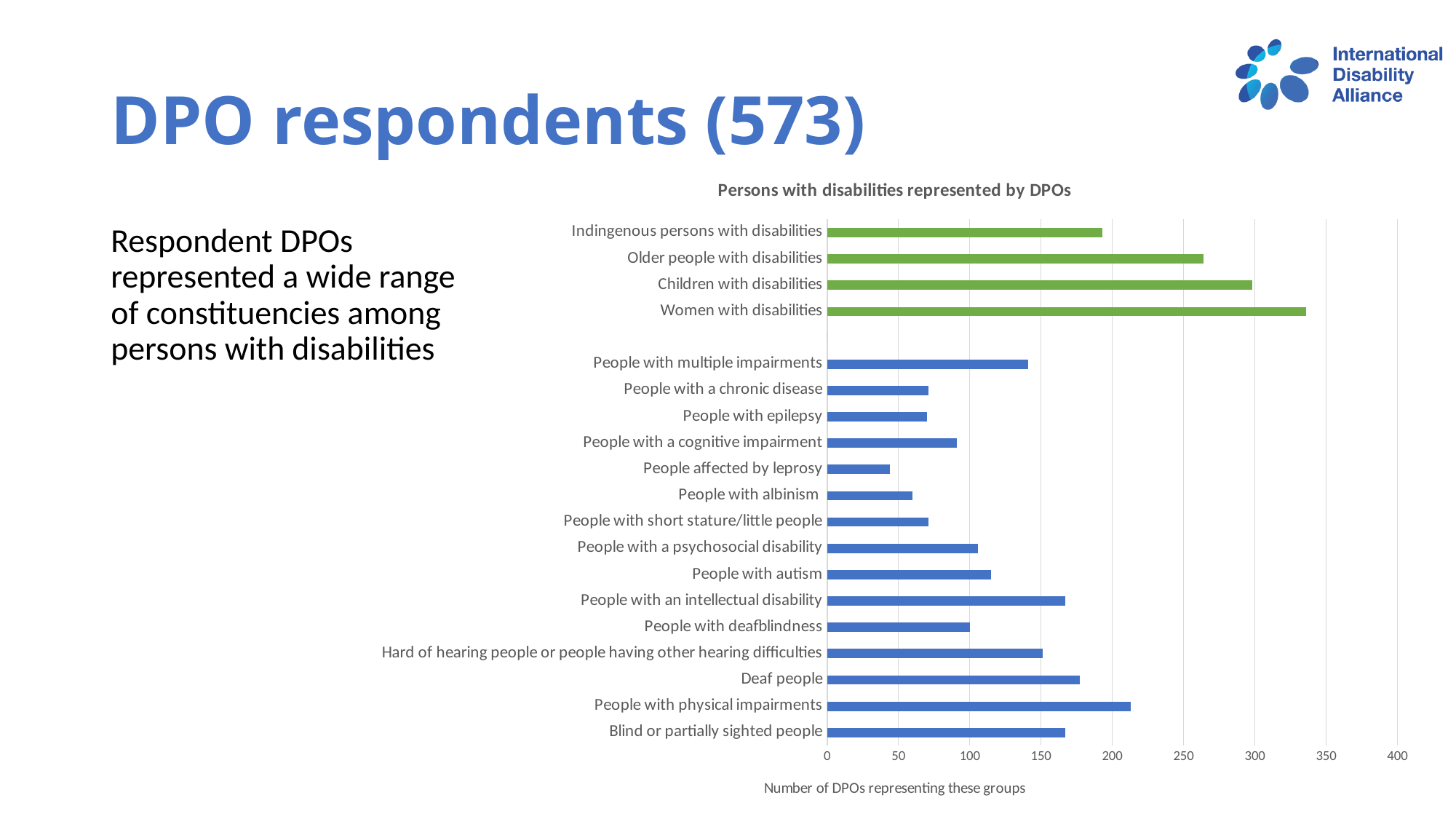
Which group has the highest number of DPOs representing it? Women with disabilities Is the value for Older people with disabilities greater or less than 250? greater Is the value for People with physical impairments greater or less than 200? greater Is the value for Women with disabilities greater or less than 300? greater Which group has the lowest number of DPOs representing it? People affected by leprosy What is the title of the chart? Persons with disabilities represented by DPOs What kind of chart is shown on the slide? bar chart Which has more DPOs representing it: People with physical impairments or People with an intellectual disability? People with physical impairments Which has more DPOs representing it: Deaf people or Blind or partially sighted people? Deaf people How many groups (categories) are plotted in the chart? 19